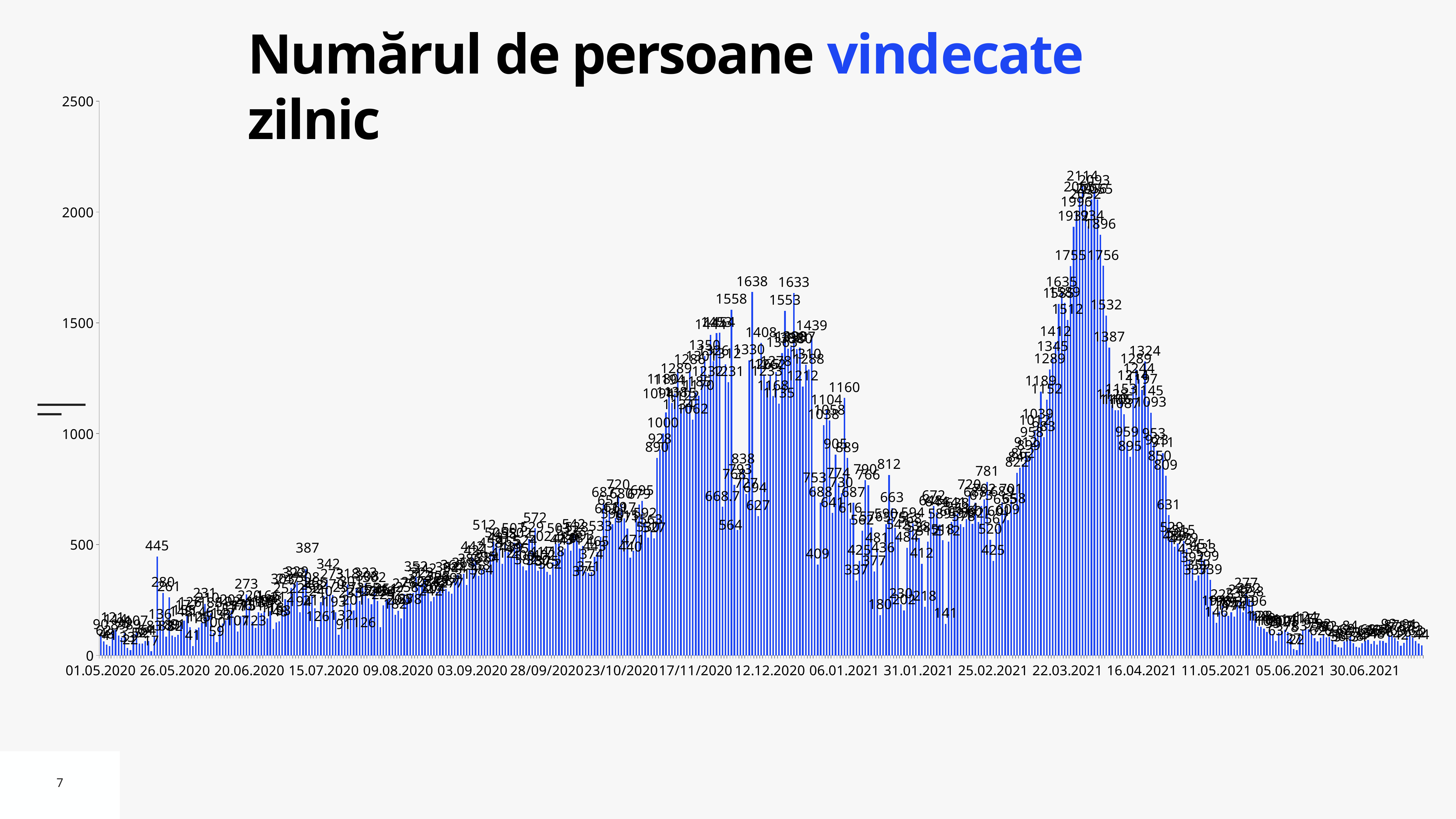
Do the values generally rise or fall from 01.05.2020 to 12.12.2020? rise What is the title of the chart on the slide? Numărul de persoane vindecate zilnic What kind of chart is shown on the slide? bar chart Is the value for the bars around 01.05.2020 greater or less than 500? less What is the difference between the chart's highest value, 2114, and the December 2020 peak of 1638? 476 What is the highest value shown on the y axis of the chart? 2500 Do the values generally rise or fall from 22.03.2021 to 30.06.2021? fall Is the value for the bars around 16.04.2021 greater or less than 1000? greater Is the value for the bars around 12.12.2020 greater or less than 1000? greater What is the highest value labeled on the chart? 2114 Which peak is higher: the one around 12.12.2020 or the one around 22.03.2021? 22.03.2021